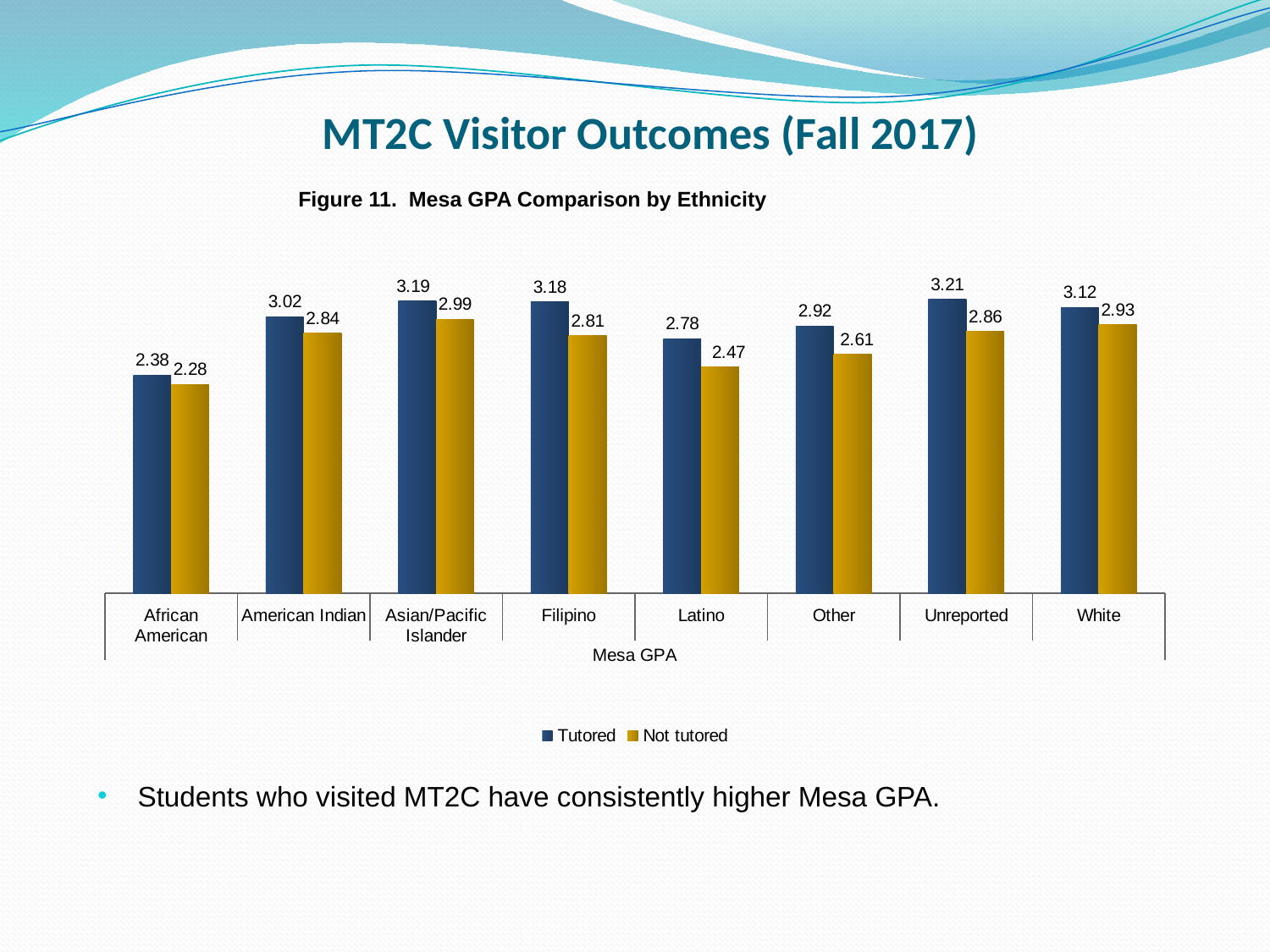
Which ethnicity category has the lowest Not tutored Mesa GPA? African American What kind of chart is shown on the slide? Bar chart What is the Tutored Mesa GPA for Filipino students? 3.18 What is the figure title of the chart? Figure 11. Mesa GPA Comparison by Ethnicity Which ethnicity category has the highest Tutored Mesa GPA? Unreported Which is larger: the Tutored GPA for Other students or the Not tutored GPA for Asian/Pacific Islander students? Not tutored GPA for Asian/Pacific Islander students What is the Not tutored Mesa GPA for White students? 2.93 What is the Not tutored Mesa GPA for Latino students? 2.47 What is the difference between the Tutored and Not tutored Mesa GPA for Latino students? 0.31 How many series does the legend list? 2 What is the difference between the Tutored and Not tutored Mesa GPA for Asian/Pacific Islander students? 0.20 How many ethnicity categories are shown on the x axis? 8